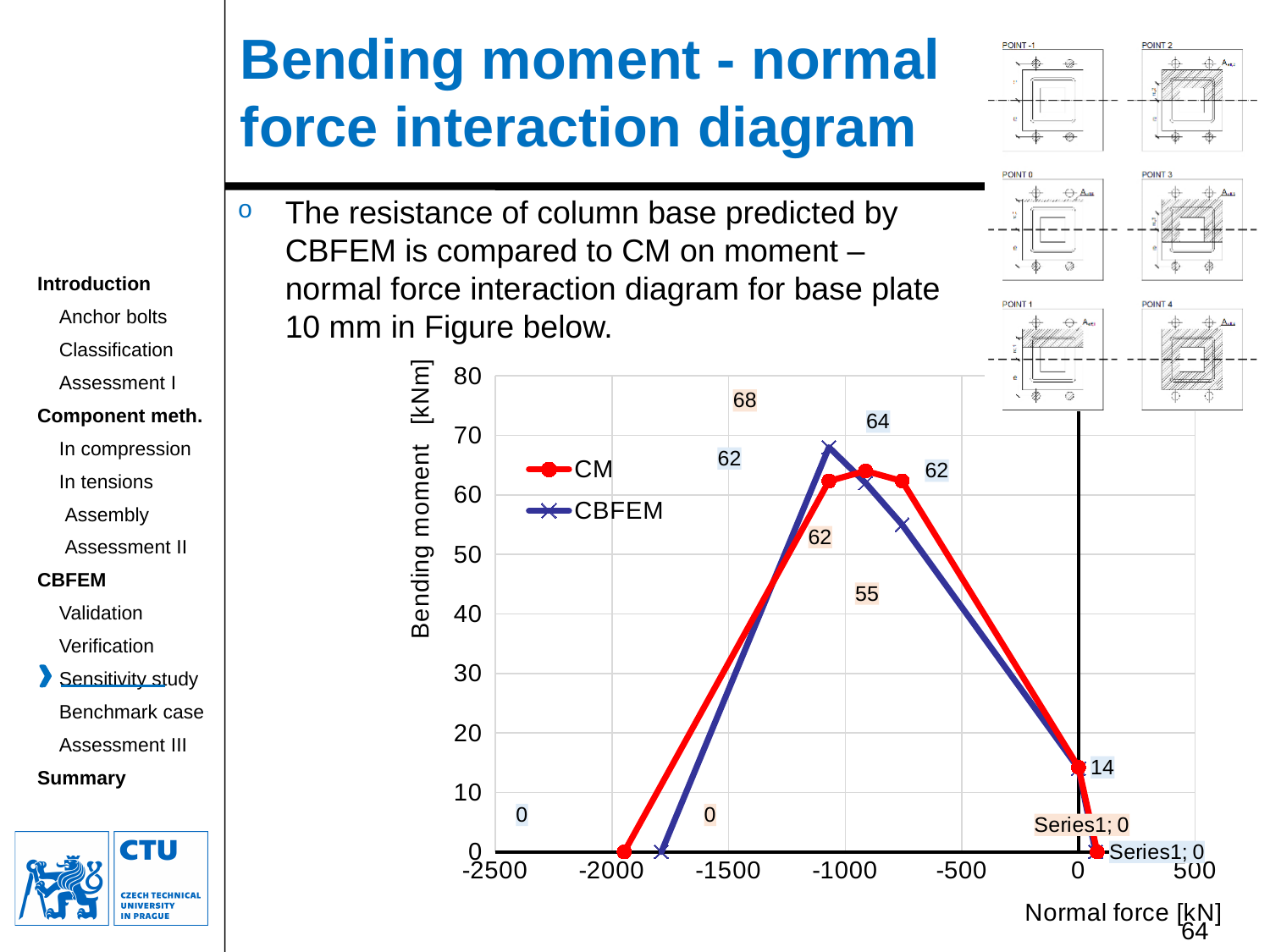
What kind of chart is shown on the slide? line chart Is the peak bending moment of the CBFEM series greater or less than 60? greater Is the bending moment of the CM series at a normal force of 0 kN greater or less than 20? less At a normal force of about -1000 kN, which series has the larger bending moment, CM or CBFEM? CBFEM Is the peak bending moment of the CM series greater or less than 70? less How many series does the chart legend list? 2 Which series reaches the higher peak bending moment, CM or CBFEM? CBFEM What is the title of the horizontal axis of the chart? Normal force [kN] Between a normal force of -1000 kN and 0 kN, do the bending moment values of the CM series rise or fall? fall What are the two series named in the chart legend? CM and CBFEM Between a normal force of -2000 kN and -1000 kN, do the bending moment values of the CBFEM series rise or fall? rise